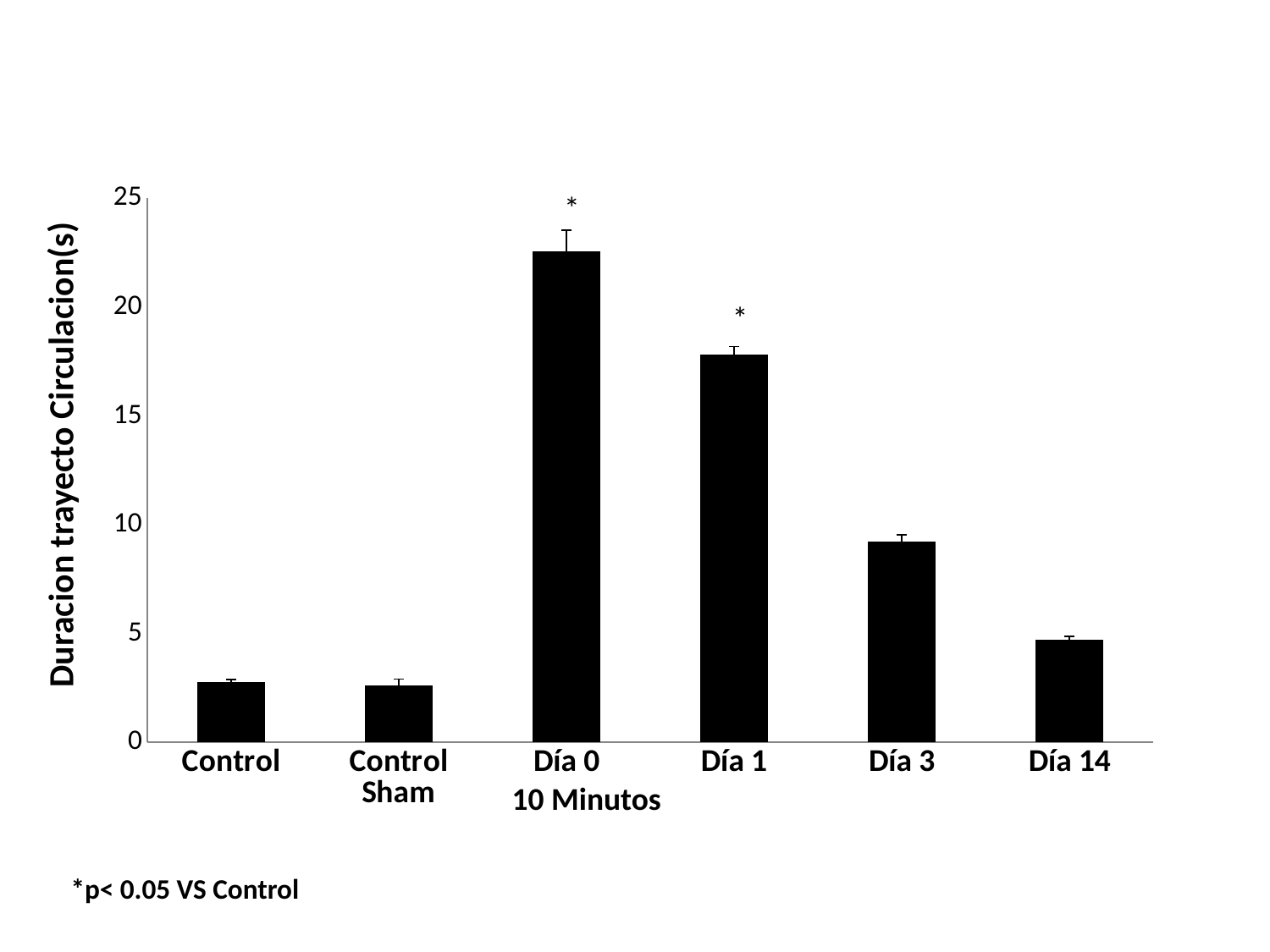
Which is larger, the value for Día 1 or the value for Día 3? Día 1 Is the value for Día 1 greater or less than 15? greater How many categories are plotted on the x axis? 6 What kind of chart is shown on the slide? bar chart Is the value for Día 14 greater or less than 5? less Which categories are marked with an asterisk? Día 0 and Día 1 Is the value for Control greater or less than 5? less Which category has the highest value? Día 0 What is the label of the y axis? Duracion trayecto Circulacion(s)